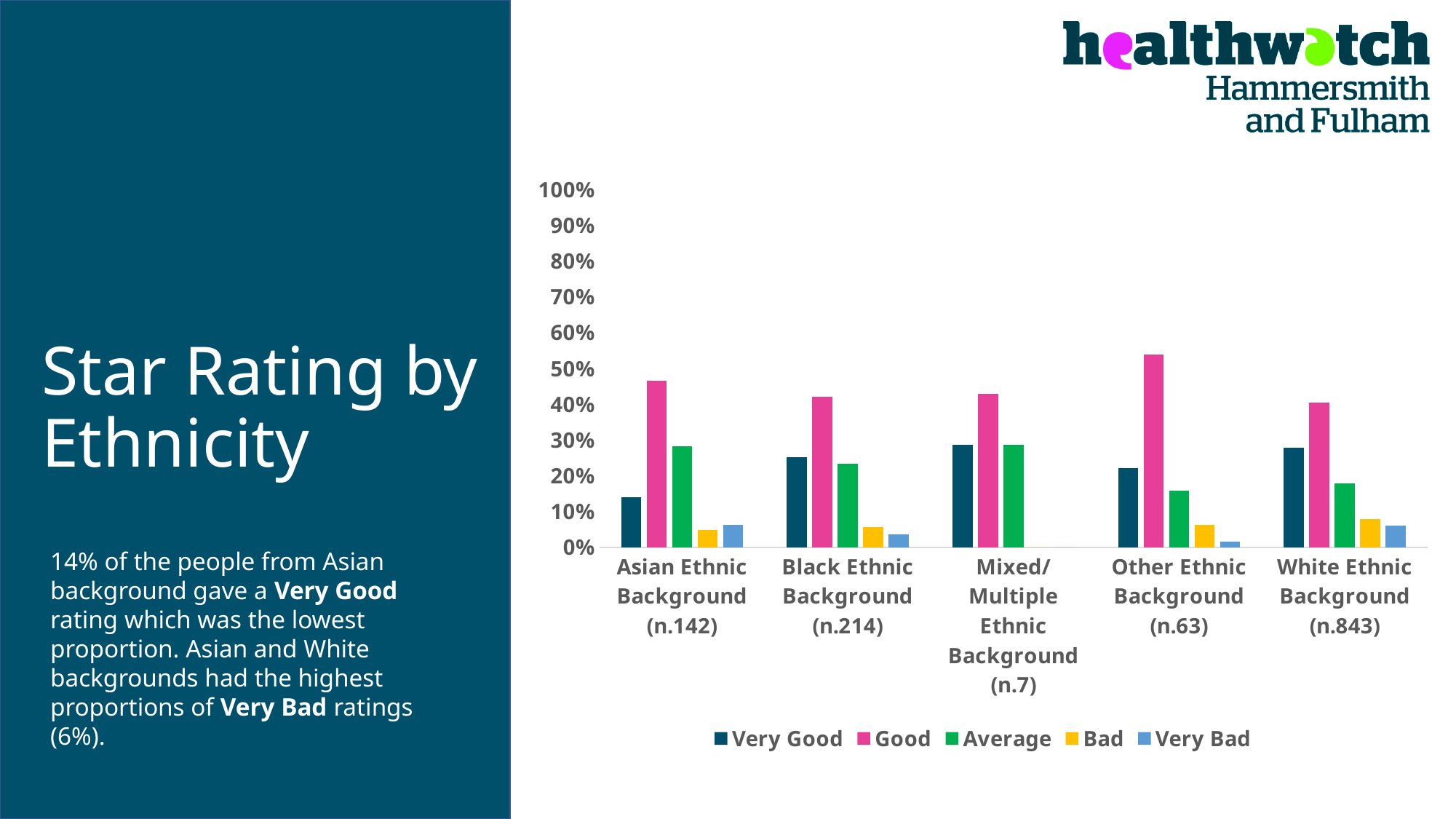
What is the sample size (n) shown for the White Ethnic Background category? 843 Is the Average value for White Ethnic Background greater or less than 20%? less Which ethnic background has the lowest proportion of Very Good ratings? Asian Ethnic Background How many series does the legend list? 5 Is the Good value for Asian Ethnic Background greater or less than 50%? less What percentage of people from an Asian Ethnic Background gave a Very Good rating? 14% Which is larger for Black Ethnic Background: the Good value or the Very Good value? Good Which colour represents the Good series in the legend? pink How many ethnic background categories are shown on the x axis? 5 What kind of chart is shown on the slide? bar chart Is the Good value for Other Ethnic Background greater or less than 50%? greater Which ethnic background has the highest proportion of Good ratings? Other Ethnic Background